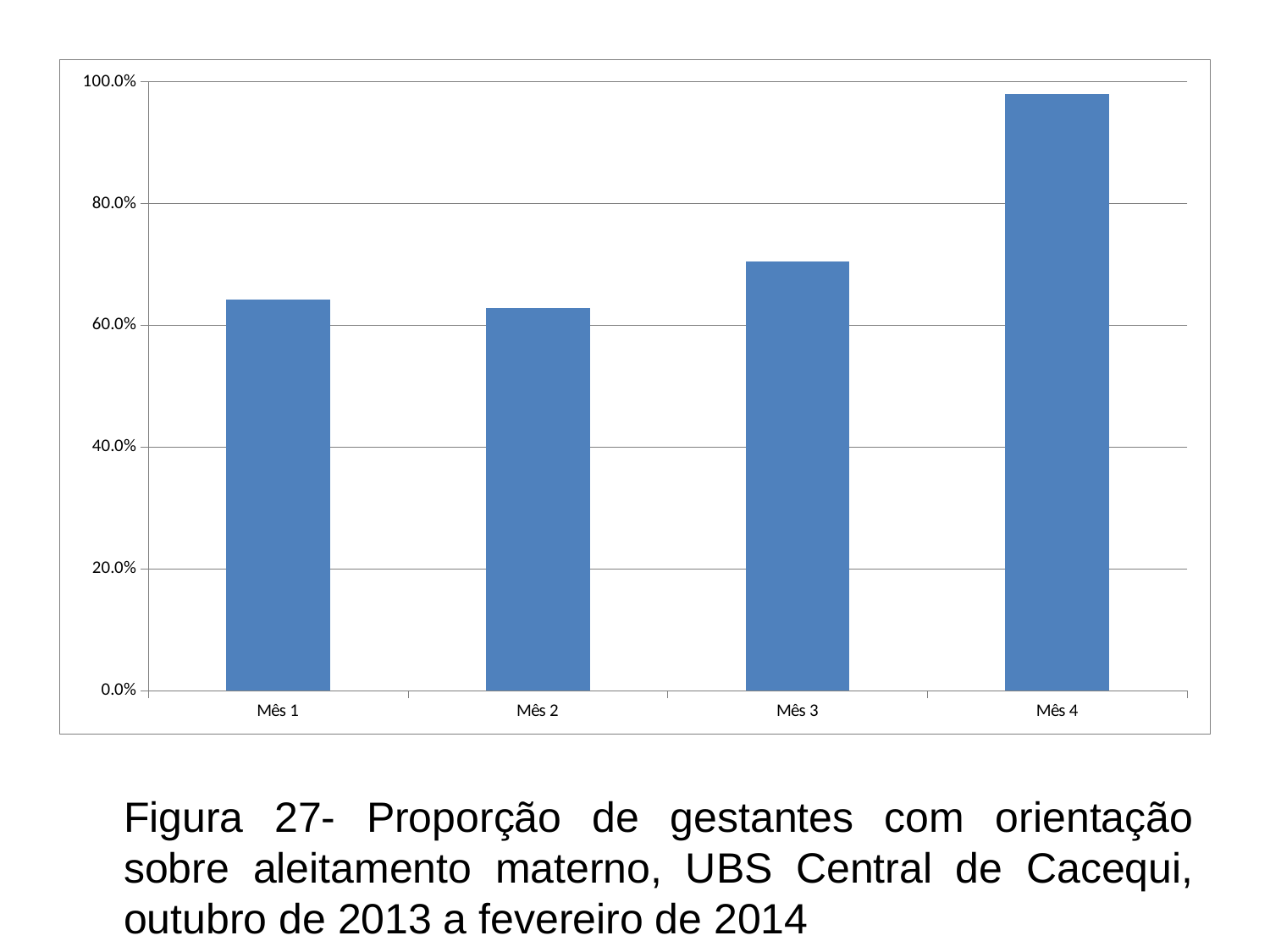
Is the value for Mês 3 greater or less than 80.0%? less Which is larger, the value for Mês 3 or the value for Mês 1? Mês 3 Is the value for Mês 3 greater or less than 60.0%? greater Which is larger, the value for Mês 4 or the value for Mês 3? Mês 4 How many categories (months) are shown on the x axis of the chart? 4 Is the value for Mês 1 greater or less than 60.0%? greater What figure number is given in the caption below the chart? Figura 27 Which month has the highest value in the chart? Mês 4 What kind of chart is shown on the slide? bar chart Does the value rise or fall from Mês 3 to Mês 4? rise